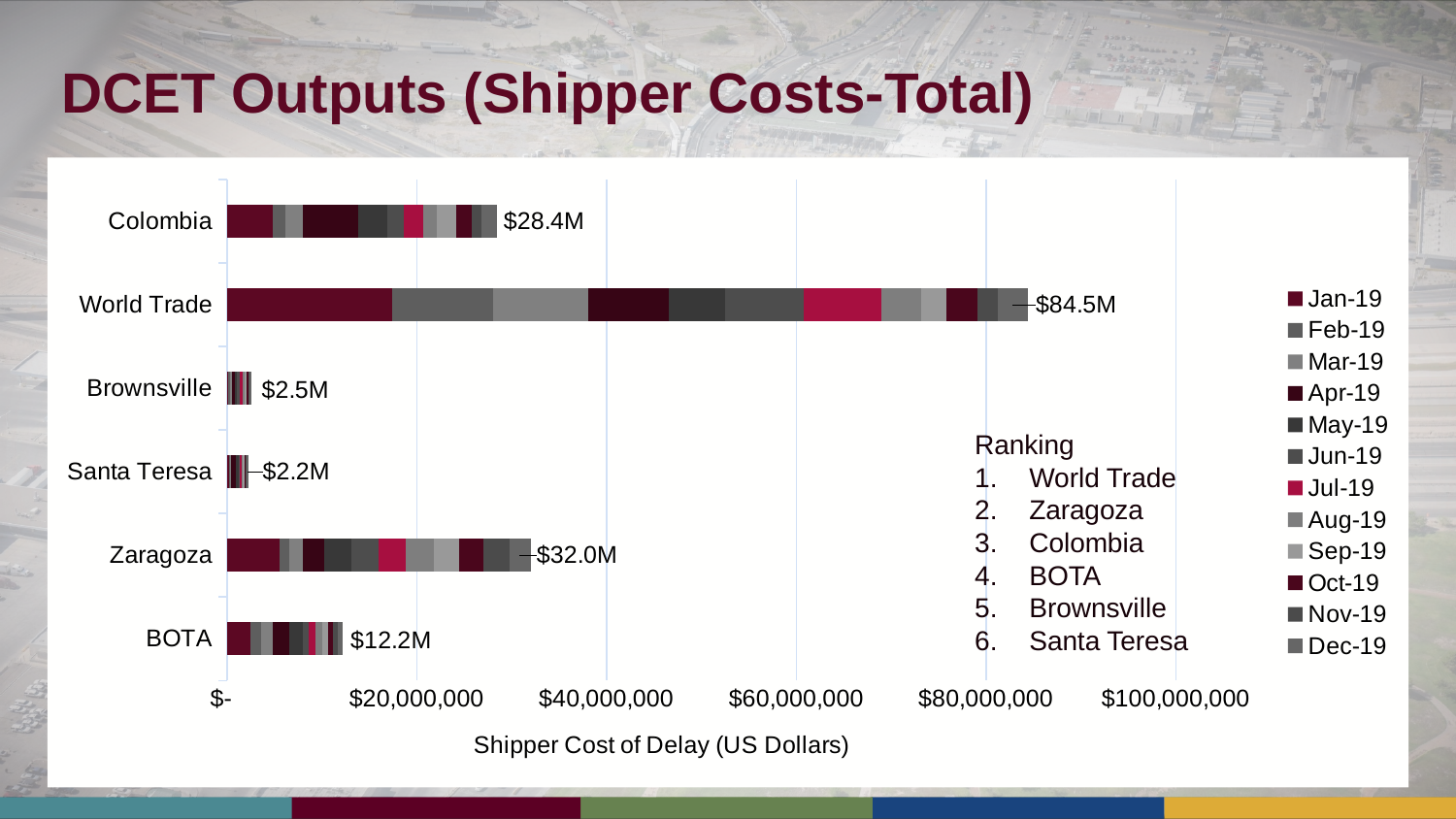
What is the difference between the total shipper cost of delay for Colombia and BOTA? $16.2M What is the difference between the total shipper cost of delay for World Trade and Zaragoza? $52.5M Is the total value for World Trade greater or less than $80,000,000? greater What is the total shipper cost of delay shown for BOTA? $12.2M Which has a larger total shipper cost of delay, Zaragoza or Colombia? Zaragoza How many series does the legend list? 12 What kind of chart is shown on the slide? Stacked bar chart What is the total shipper cost of delay shown for Zaragoza? $32.0M Which port of entry has the lowest total shipper cost of delay? Santa Teresa Which port of entry has the highest total shipper cost of delay? World Trade What is the total shipper cost of delay shown for World Trade? $84.5M How many ports of entry are shown on the chart? 6